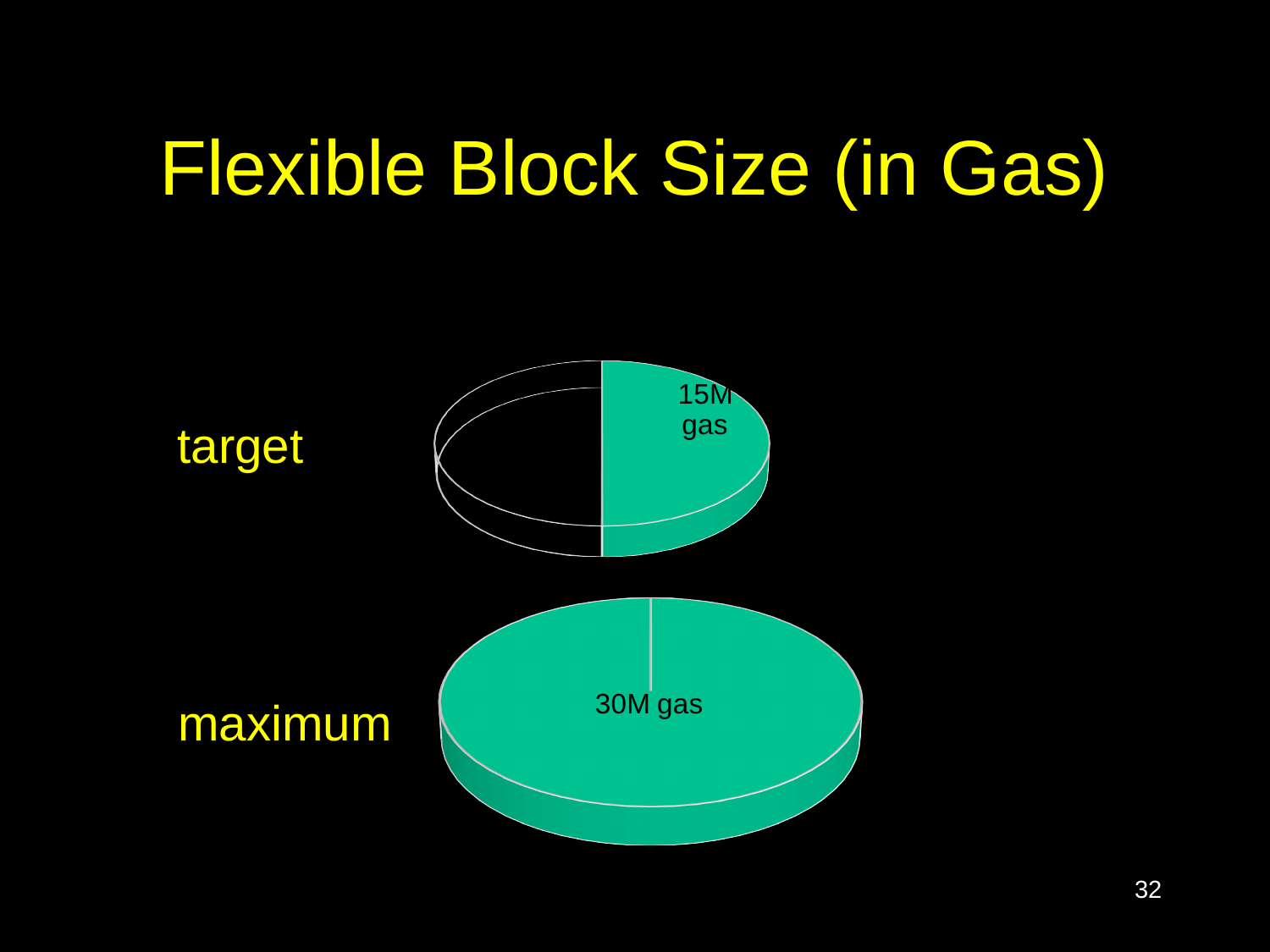
Which of the two charts shows the smaller gas value? target In the target chart, what value is printed on the filled slice? 15M gas What is the title of the slide containing the charts? Flexible Block Size (in Gas) In the maximum chart, what value is printed on the pie? 30M gas What is the difference between the maximum value and the target value? 15M gas Which chart is positioned above the other on the slide, target or maximum? target What colour is the filled portion of the pie charts? green Which chart shows the larger gas value, target or maximum? maximum How many pie charts are on the slide? 2 What kind of charts are shown on the slide? pie charts